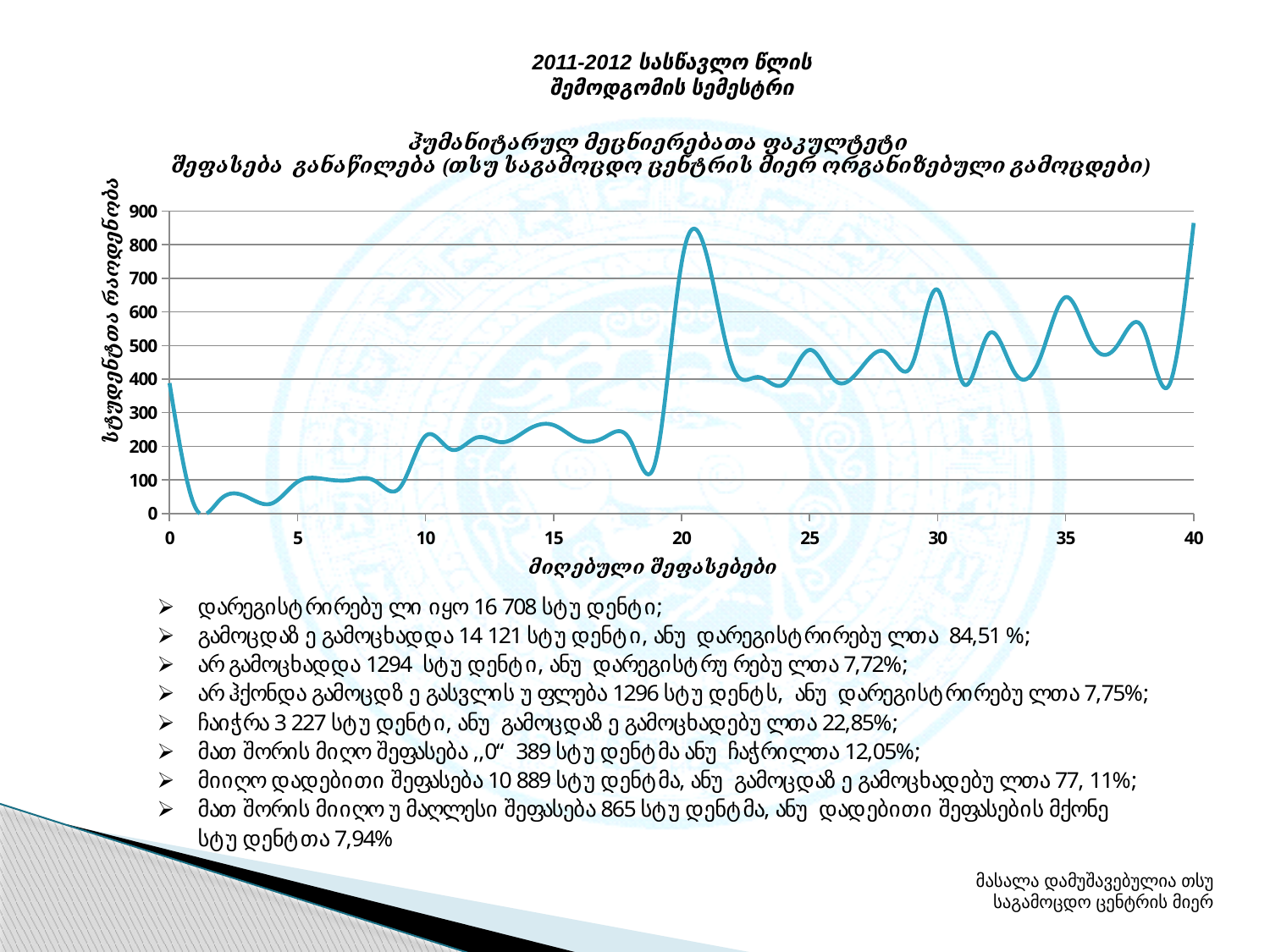
Is the value of the line at x = 30 greater or less than 500? greater Does the line rise or fall between x = 0 and x = 1? fall What is the highest tick value shown on the horizontal axis? 40 Is the value of the line at x = 10 greater or less than 300? less Is the value of the line at x = 0 greater or less than 300? greater Is the value at x = 30 larger or smaller than the value at x = 10? larger What kind of chart is shown on the slide? line chart What is the highest tick value shown on the vertical axis? 900 Does the line rise or fall between x = 19 and x = 20? rise